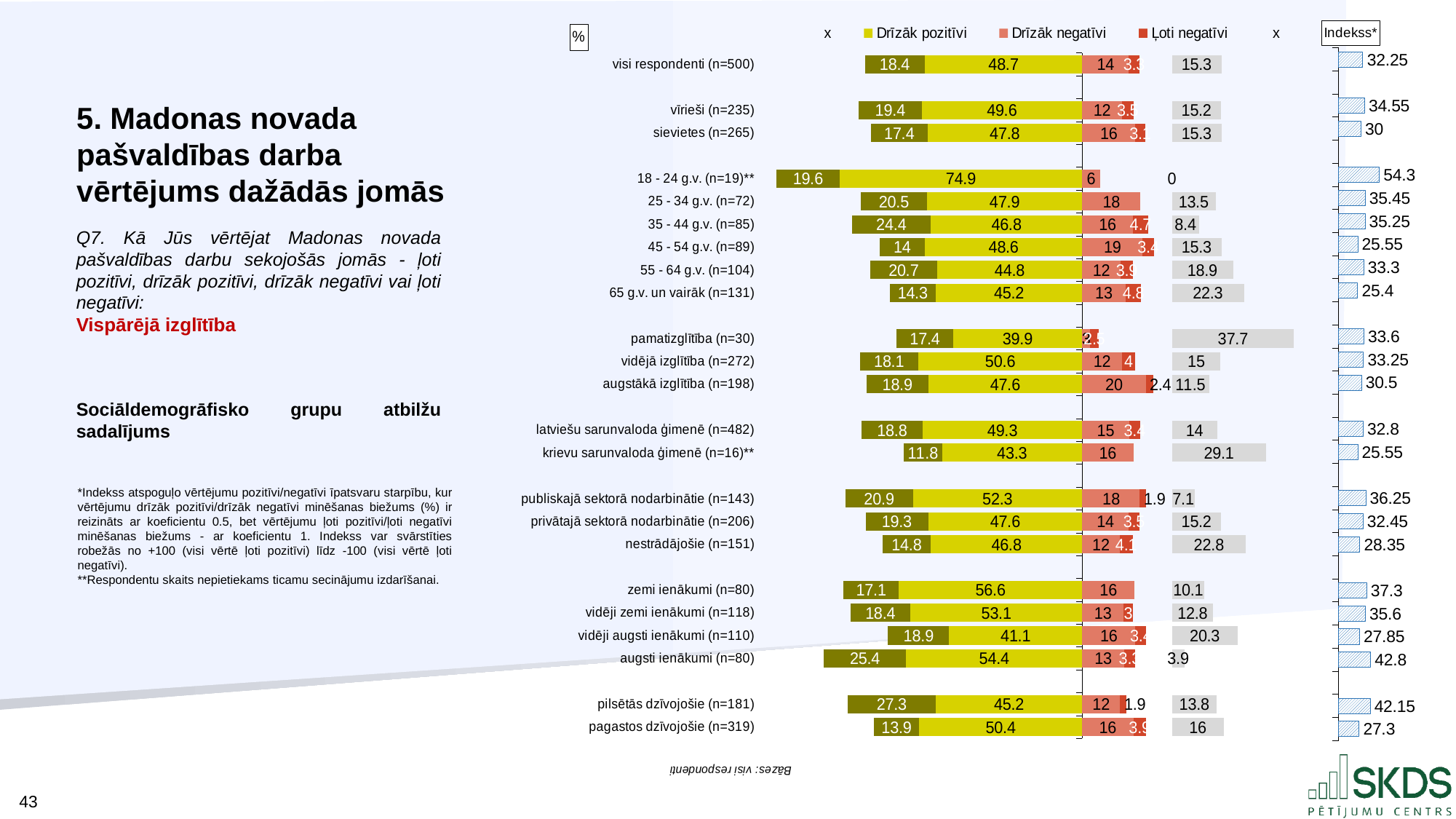
What kind of chart is shown on the slide? bar chart How many respondent groups are plotted in the chart? 23 Which has the larger 'Drīzāk pozitīvi' value: 'zemi ienākumi (n=80)' or 'augsti ienākumi (n=80)'? zemi ienākumi (n=80) Which group has the highest 'Drīzāk pozitīvi' value? 18 - 24 g.v. (n=19)** Which group has the highest 'Indekss*' value? 18 - 24 g.v. (n=19)** What is the difference between the 'Indekss*' values for 'pilsētās dzīvojošie (n=181)' and 'pagastos dzīvojošie (n=319)'? 14.85 What colour represents 'Drīzāk pozitīvi' in the legend? yellow Which group has the lowest 'Indekss*' value? 65 g.v. un vairāk (n=131) What is the 'Indekss*' value for 'augsti ienākumi (n=80)'? 42.8 What is the 'Drīzāk pozitīvi' value for the group '18 - 24 g.v. (n=19)**'? 74.9 How many series does the legend list? 3 What is the 'Drīzāk negatīvi' value for 'augstākā izglītība (n=198)'? 20